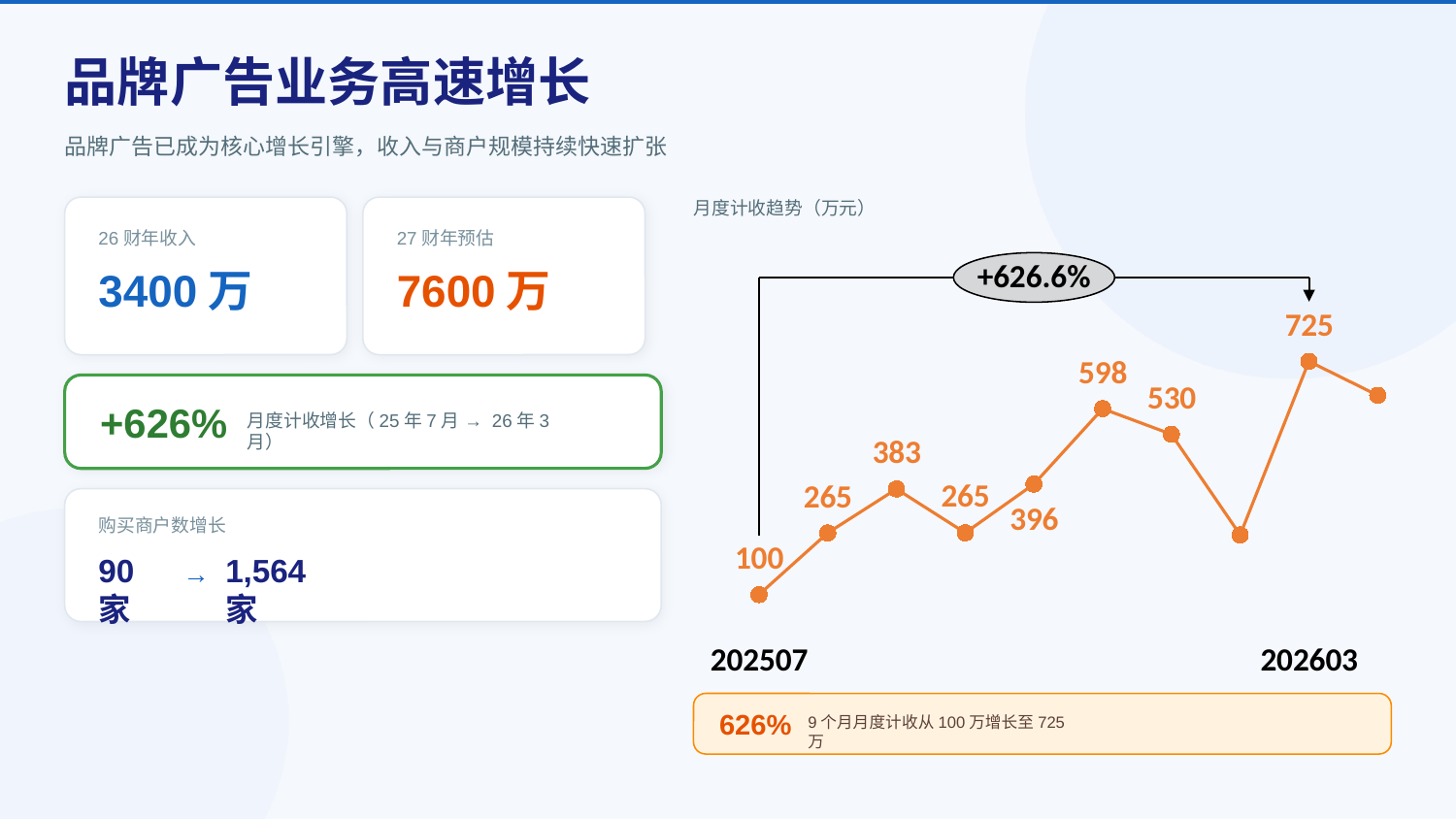
What is the difference between the points labeled 598 and 530 in the chart? 68 What kind of chart is shown on the slide? Line chart What is the value of the first data point (202507) in the monthly revenue trend chart? 100 What percentage growth is shown in the annotation above the chart? +626.6% What is the difference between the highest labeled value (725) and the first value (100) in the chart? 625 Which is larger in the chart, the point labeled 598 or the point labeled 530? 598 What is the highest labeled value in the monthly revenue trend chart? 725 What is the title of the chart on the right of the slide? 月度计收趋势（万元） What is the difference between the points labeled 383 and the following point labeled 265? 118 Overall, do the values in the monthly revenue trend chart rise or fall from 202507 to 202603? Rise How many data points in the chart have printed value labels? 8 What is the lowest labeled value in the monthly revenue trend chart? 100